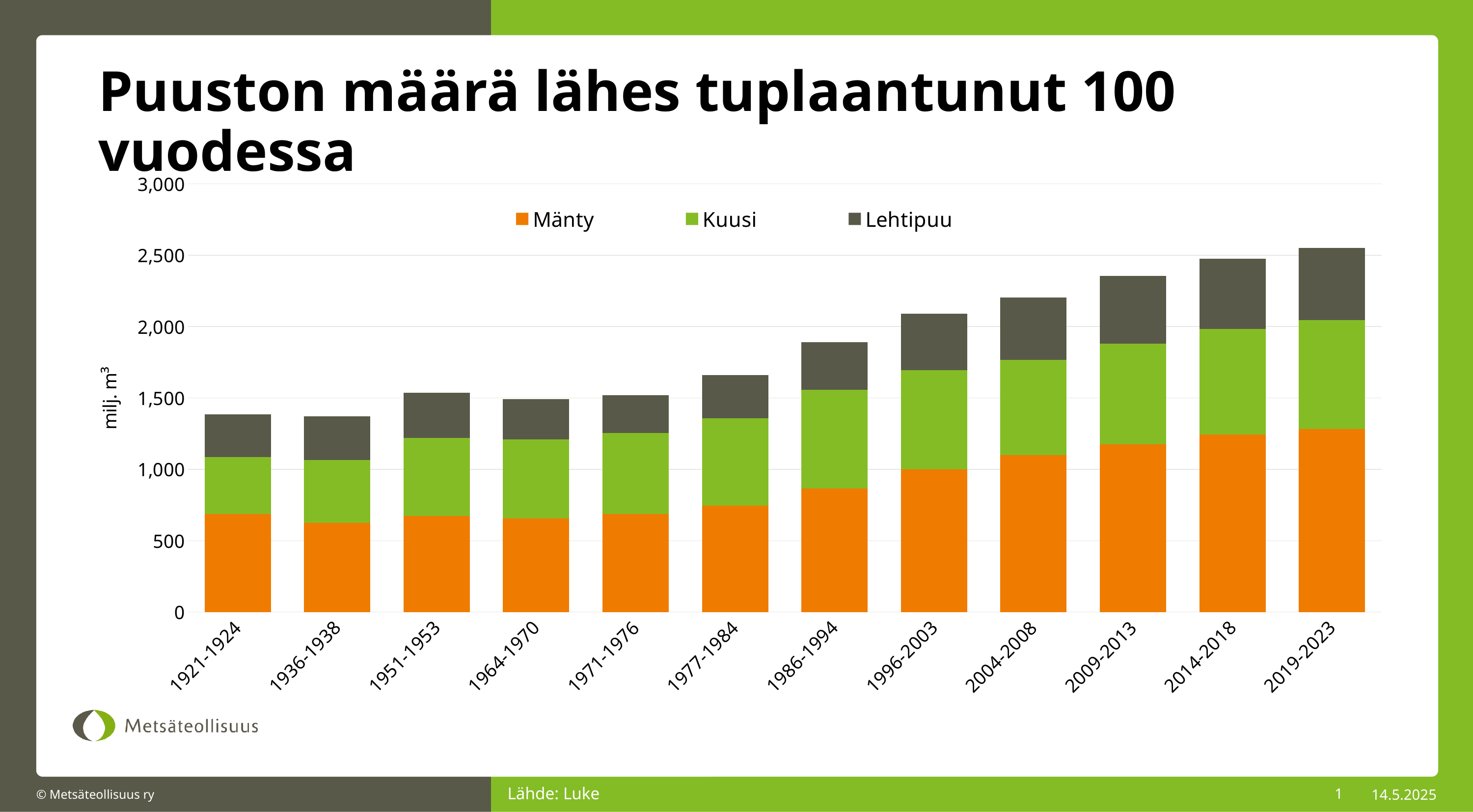
How many series does the legend list? 3 What unit is shown on the y axis? milj. m³ How many time periods are shown on the x axis? 12 Is the total value for 2004-2008 greater or less than 2,000? greater Do the total values generally rise or fall from 1921-1924 to 2019-2023? rise Is the total value for 1921-1924 greater or less than 1,500? less Is the Mänty value for 1921-1924 greater or less than 500? greater Which is larger, the Mänty value for 2009-2013 or the Mänty value for 1977-1984? 2009-2013 Which period has the highest total stacked bar? 2019-2023 What kind of chart is shown on the slide? stacked bar chart Which is larger, the total for 2019-2023 or the total for 1921-1924? 2019-2023